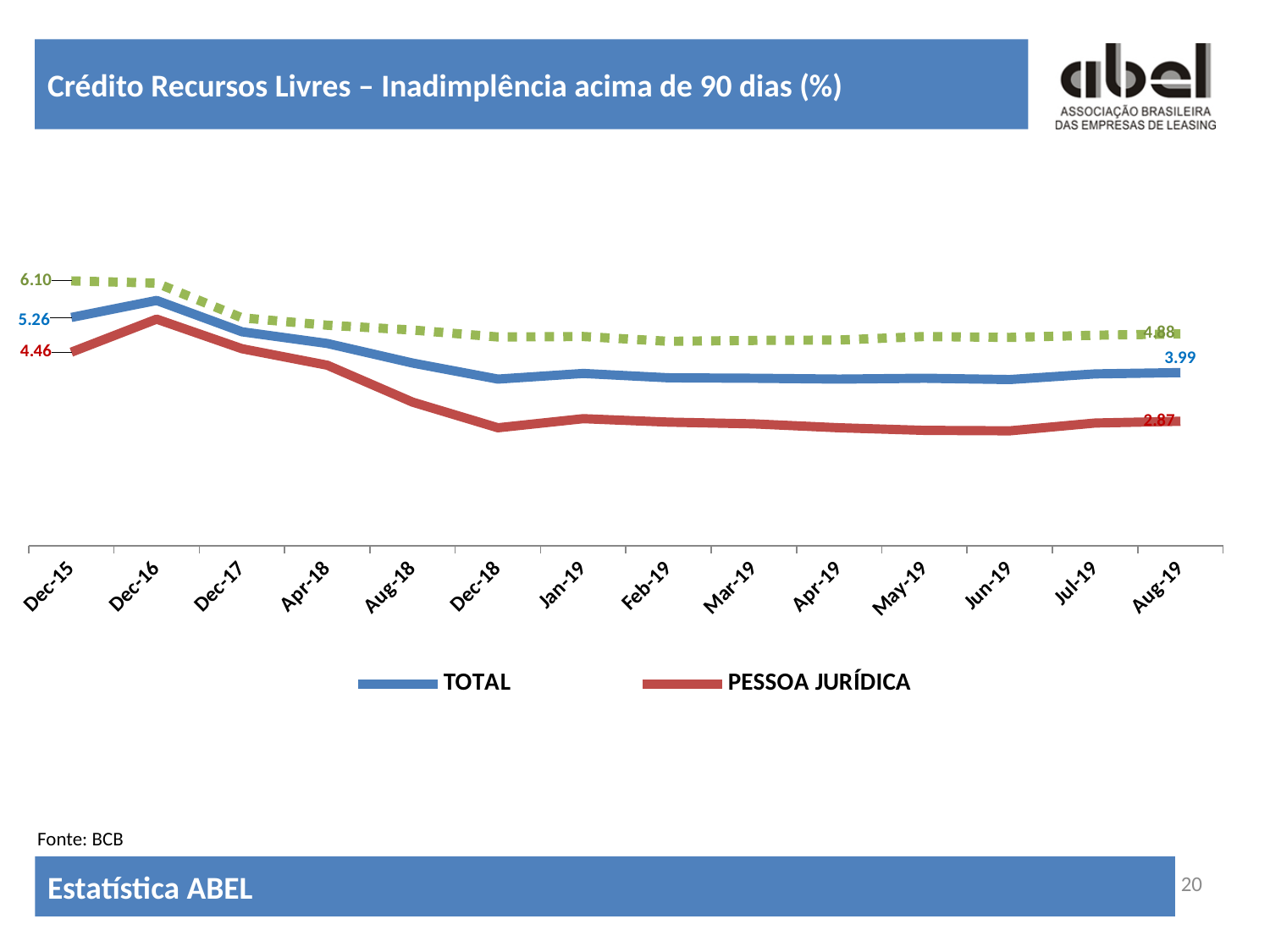
How many series does the legend list? 2 By how much did the TOTAL value fall from Dec-15 to Aug-19? 1.27 What is the value of TOTAL at Aug-19? 3.99 What is the value of PESSOA JURÍDICA at Aug-19? 2.87 By how much did the PESSOA JURÍDICA value fall from Dec-15 to Aug-19? 1.59 What kind of chart is shown on the slide? line chart How many dates are shown on the x axis? 14 What is the title of the chart? Crédito Recursos Livres – Inadimplência acima de 90 dias (%) What is the value of PESSOA JURÍDICA at Dec-15? 4.46 Does the TOTAL line rise or fall overall from Dec-15 to Aug-19? fall At Aug-19, which series has the higher value, TOTAL or PESSOA JURÍDICA? TOTAL What is the value of TOTAL at Dec-15? 5.26